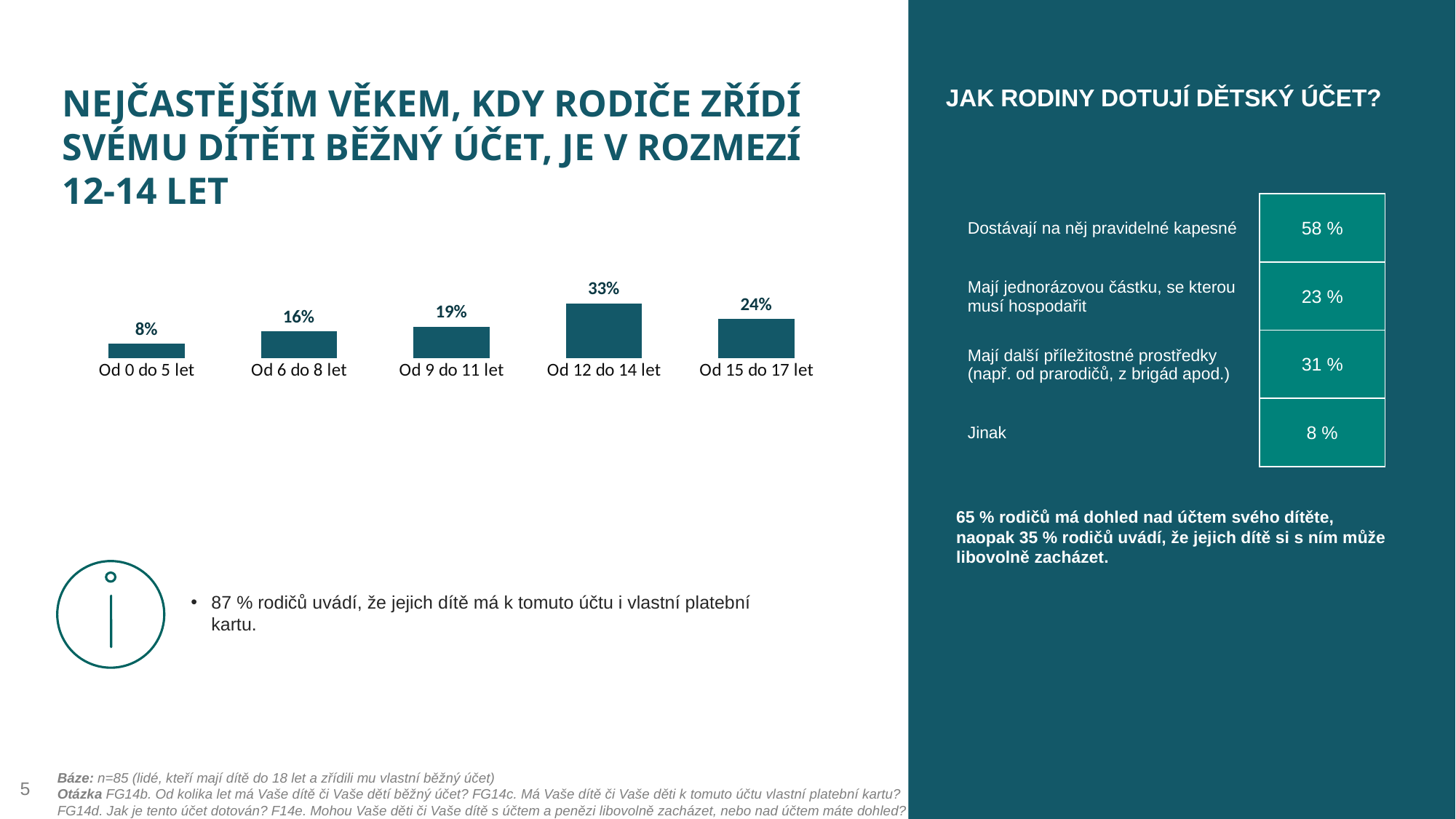
What is the value for the 'Od 0 do 5 let' category in the bar chart? 8% What type of chart is used to show the age categories on the slide? Bar chart What is the value for the 'Od 15 do 17 let' category in the bar chart? 24% Which age category has the lowest value in the bar chart? Od 0 do 5 let What is the difference between the values for 'Od 12 do 14 let' and 'Od 15 do 17 let' in the bar chart? 9% What is the value for the 'Od 9 do 11 let' category in the bar chart? 19% What is the difference between the values for 'Od 6 do 8 let' and 'Od 0 do 5 let' in the bar chart? 8% Do the values in the bar chart rise or fall from 'Od 0 do 5 let' to 'Od 12 do 14 let'? Rise Which is larger in the bar chart: the value for 'Od 9 do 11 let' or 'Od 6 do 8 let'? Od 9 do 11 let What is the value for the 'Od 12 do 14 let' category in the bar chart? 33% How many age categories are shown in the bar chart? 5 Which age category has the highest value in the bar chart? Od 12 do 14 let